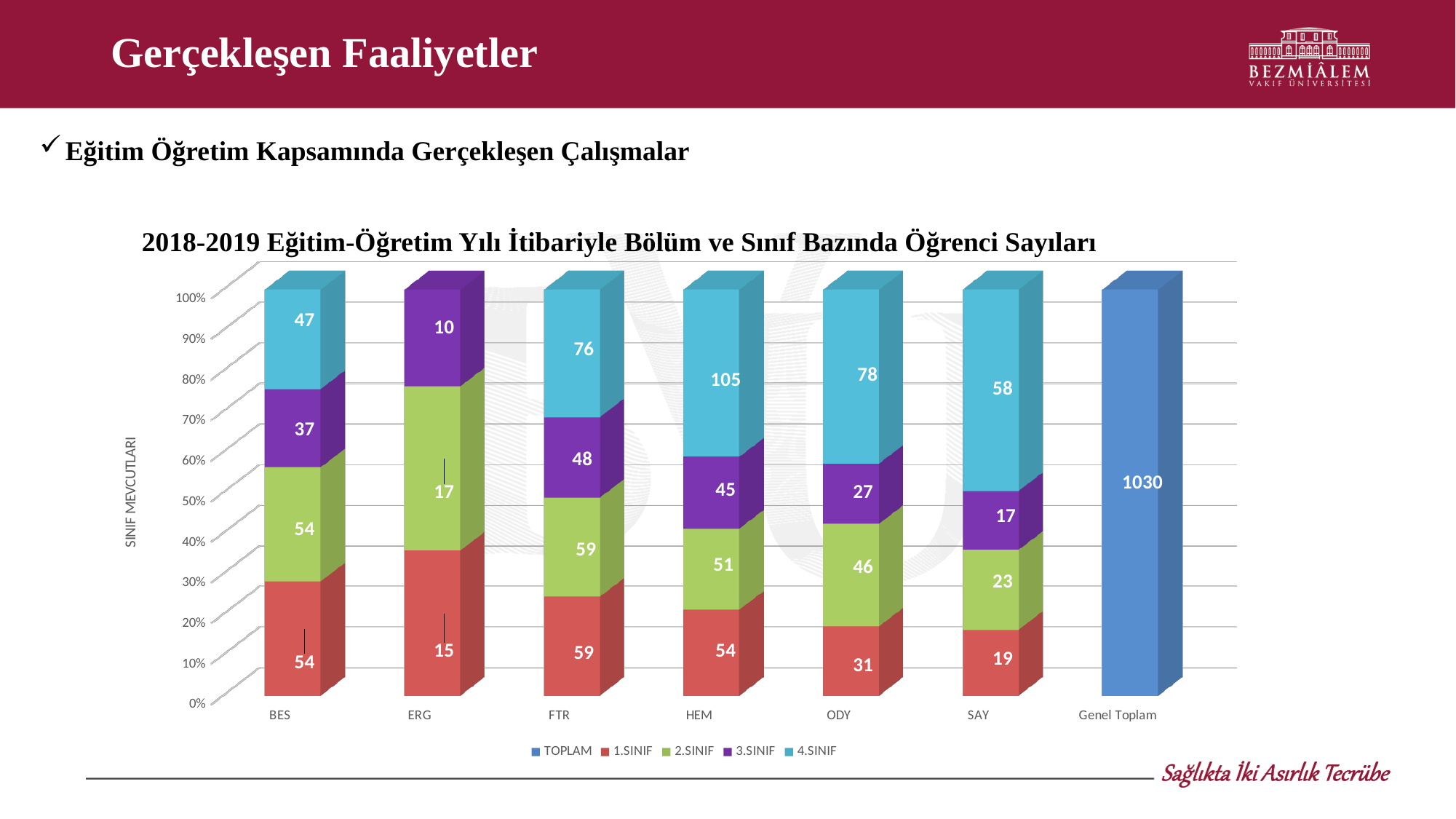
What is the value for 4.SINIF in the HEM category? 105 What is the value for 1.SINIF in the ODY category? 31 What is the difference between the 4.SINIF values for HEM and ODY? 27 What kind of chart is shown on the slide? Stacked bar chart What is the value shown for the Genel Toplam bar? 1030 Which is larger, the 2.SINIF value for FTR or the 2.SINIF value for ODY? FTR What is the total of the stacked bar for BES? 192 How many series does the legend list? 5 How many categories are shown on the x axis? 7 What is the value for 3.SINIF in the ERG category? 10 Which category has the lowest 1.SINIF value? ERG Which category has the highest 4.SINIF value? HEM